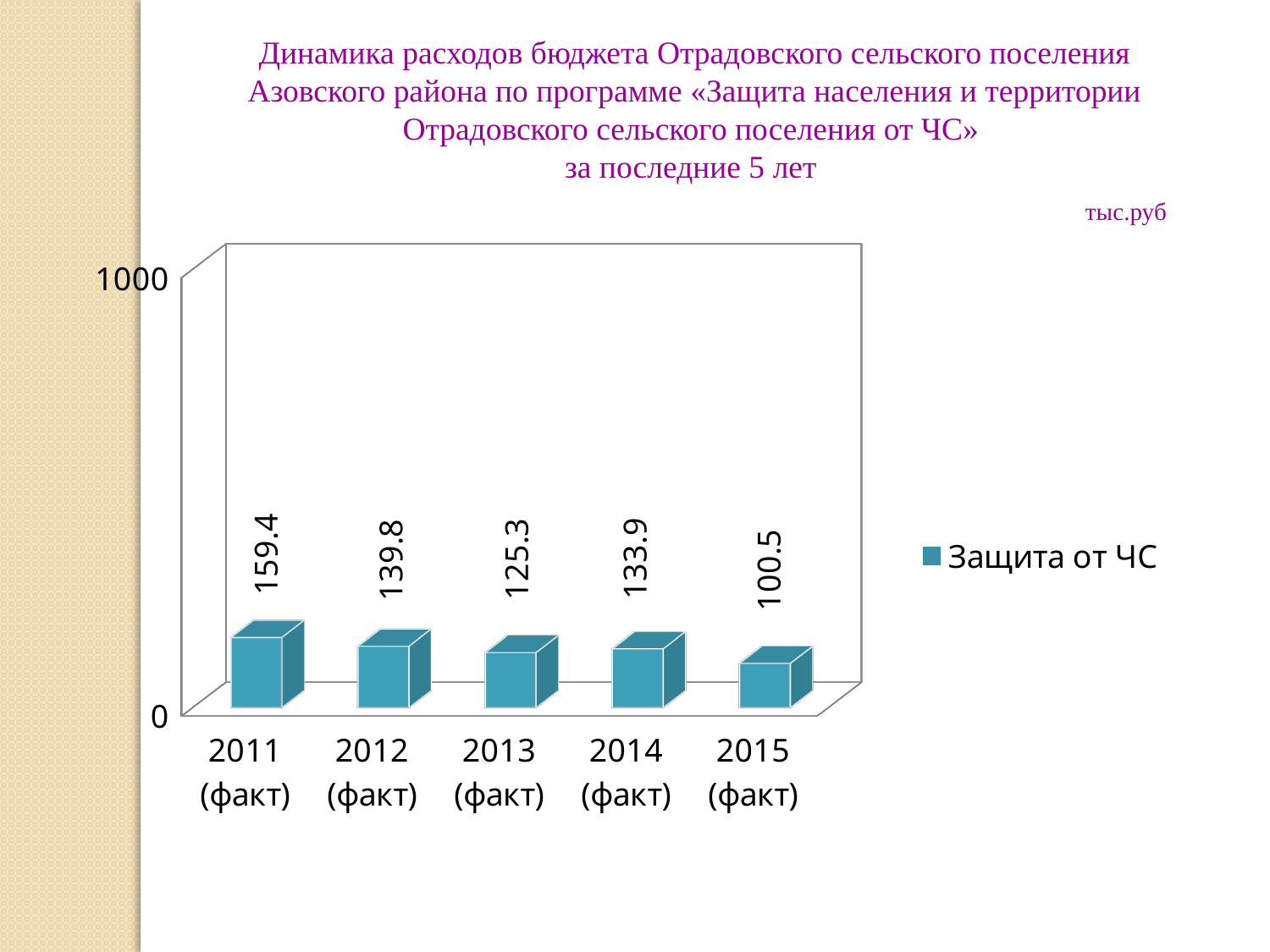
Which year has the lowest value? 2015 (факт) Which is larger, the value for 2014 (факт) or the value for 2013 (факт)? 2014 (факт) Which year has the highest value? 2011 (факт) What is the value for 2011 (факт)? 159.4 What is the difference between the values for 2012 (факт) and 2013 (факт)? 14.5 What is the value for 2013 (факт)? 125.3 How many series does the legend list? 1 What is the difference between the values for 2011 (факт) and 2015 (факт)? 58.9 How many years are shown on the x axis? 5 What is the name of the series in the legend? Защита от ЧС What kind of chart is shown? bar chart What is the value for 2015 (факт)? 100.5